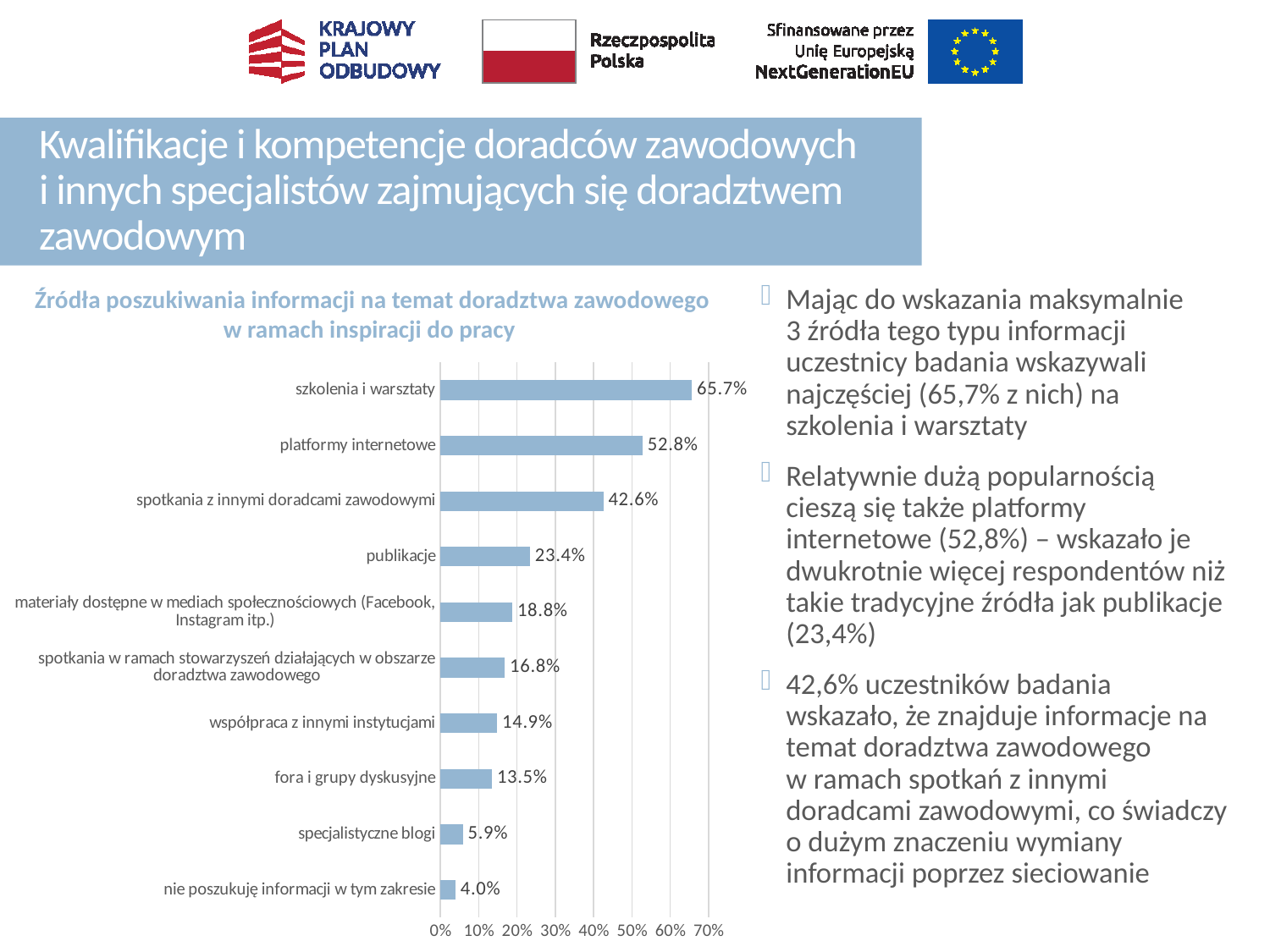
Which category has the lowest value? nie poszukuję informacji w tym zakresie What is the value for 'platformy internetowe'? 52.8% Is the value for 'spotkania z innymi doradcami zawodowymi' greater or less than 40%? greater Which is larger: 'fora i grupy dyskusyjne' or 'współpraca z innymi instytucjami'? współpraca z innymi instytucjami What is the value for 'szkolenia i warsztaty'? 65.7% What is the value for 'specjalistyczne blogi'? 5.9% What is the difference between 'szkolenia i warsztaty' and 'platformy internetowe'? 12.9% Which category has the highest value? szkolenia i warsztaty What is the title of the chart? Źródła poszukiwania informacji na temat doradztwa zawodowego w ramach inspiracji do pracy How many categories are shown in the chart? 10 What is the value for 'publikacje'? 23.4% What kind of chart is shown on the slide? bar chart